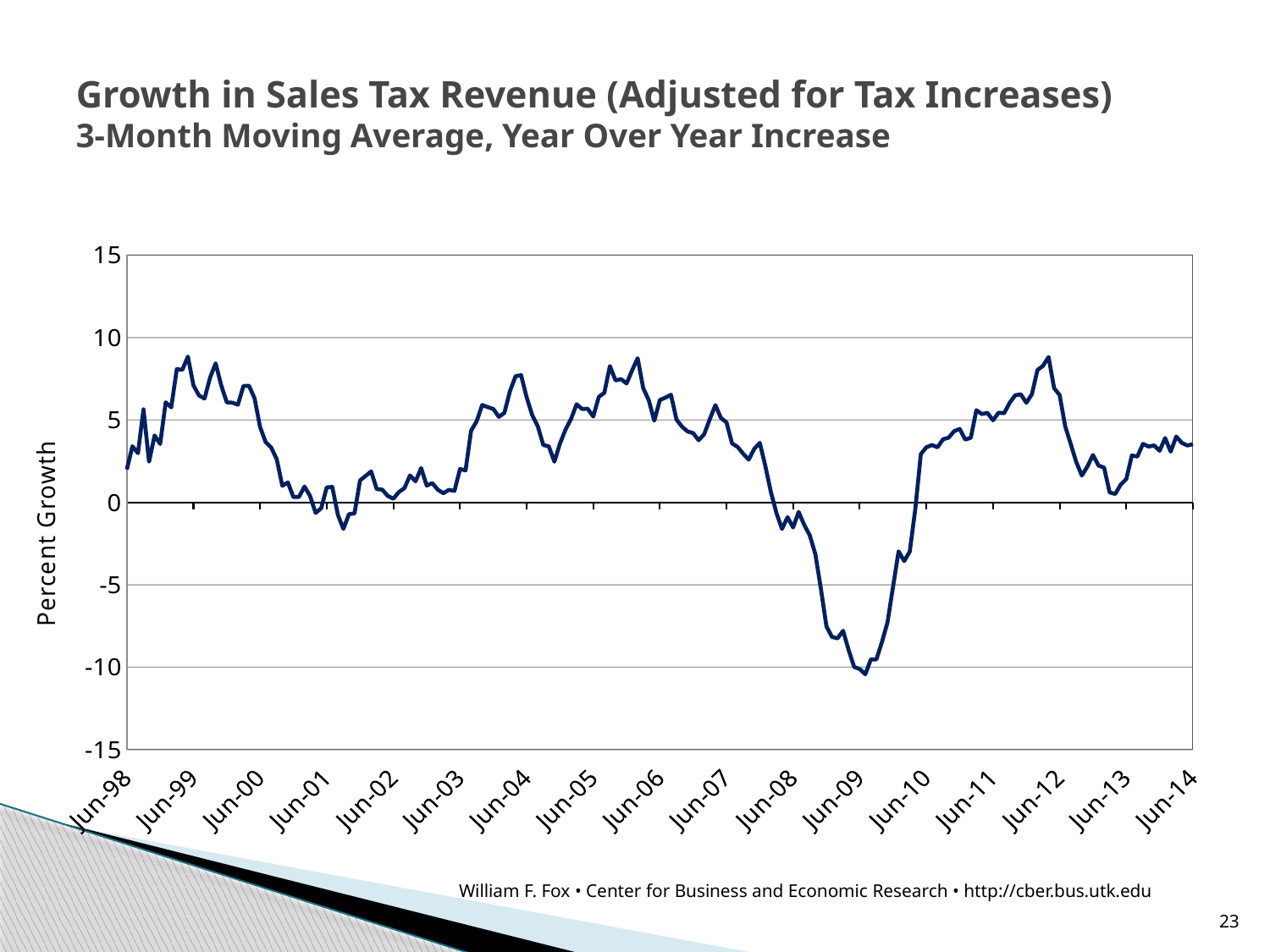
Is the value at Jun-09 greater or less than -5? less What is the title of the chart? Growth in Sales Tax Revenue (Adjusted for Tax Increases) 3-Month Moving Average, Year Over Year Increase How many date labels are shown along the x axis? 17 How many lines are plotted on the chart? 1 Is the value at Jun-02 greater or less than 5? less What is the label on the vertical axis? Percent Growth Is the value at Jun-99 greater or less than 5? greater Between which two labelled dates does the line reach its lowest point? Jun-09 and Jun-10 Do the values rise or fall from Jun-12 to Jun-13? fall What kind of chart is shown on the slide? line chart